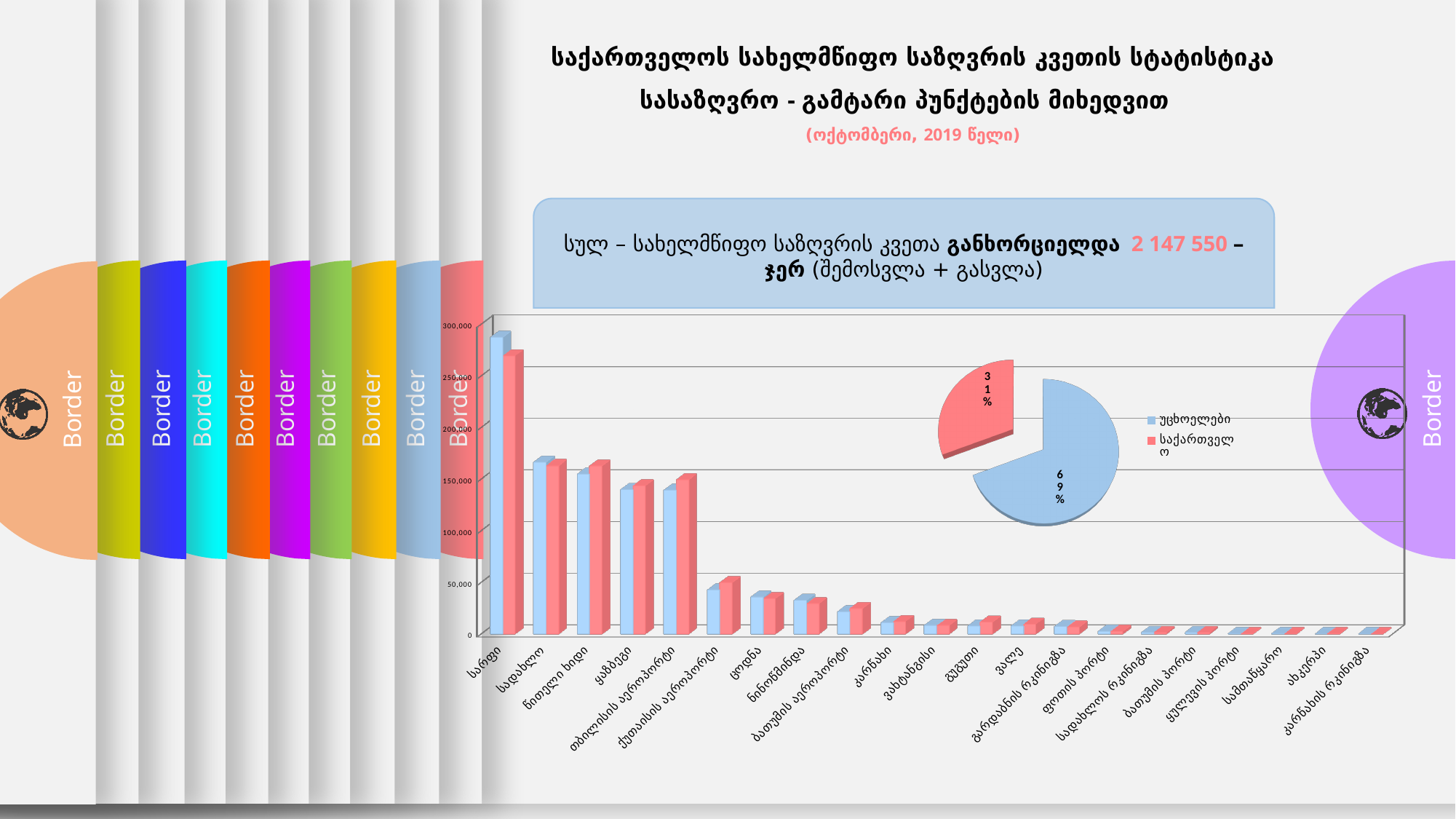
In the pie chart, what share does საქართველო have? 31% In the bar chart, which category has the highest values? სარფი What kind of chart is the large chart at the bottom of the slide? bar chart In the pie chart, which slice is larger, უცხოელები or საქართველო? უცხოელები What kind of chart is the small chart on the right showing 69% and 31%? pie chart How many categories are shown on the x axis of the bar chart? 21 In the bar chart, do the values generally rise or fall from left to right along the x axis? fall How many series does the legend list? 2 In the pie chart, what share does უცხოელები have? 69%